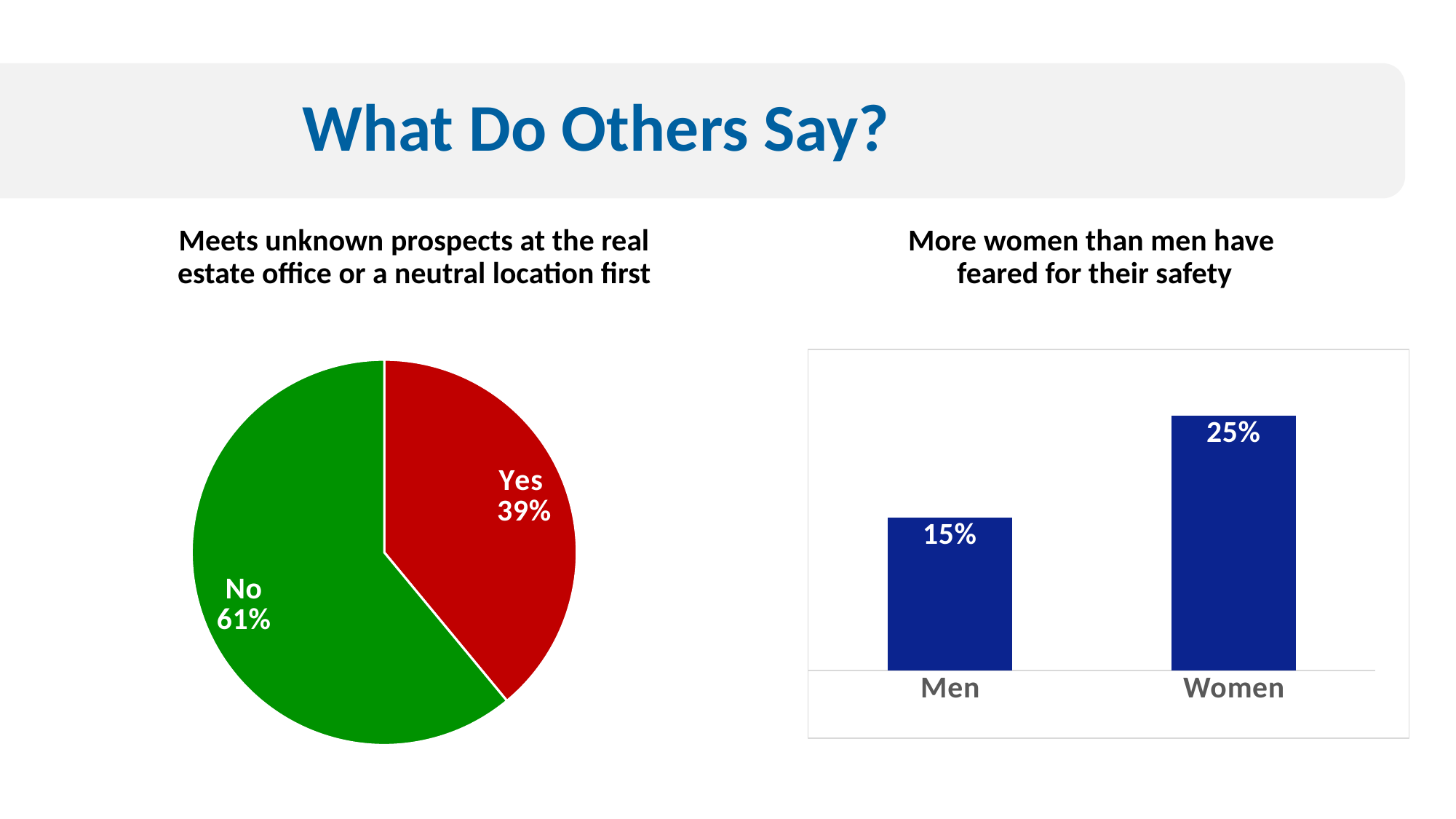
In the bar chart on the right, what is the value for Men? 15% In the pie chart on the left, which slice is larger, Yes or No? No In the bar chart on the right, what is the value for Women? 25% In the pie chart on the left, what percentage answered "Yes"? 39% In the bar chart on the right, which category has the highest value? Women In the bar chart on the right, what is the difference between the values for Women and Men? 10% In the pie chart on the left, what percentage answered "No"? 61% What type of chart is shown on the right side of the slide? Bar chart What type of chart is shown on the left side of the slide? Pie chart In the pie chart on the left, how many slices are there? 2 In the pie chart on the left, what colour is the "No" slice? Green In the bar chart on the right, how many categories are shown? 2